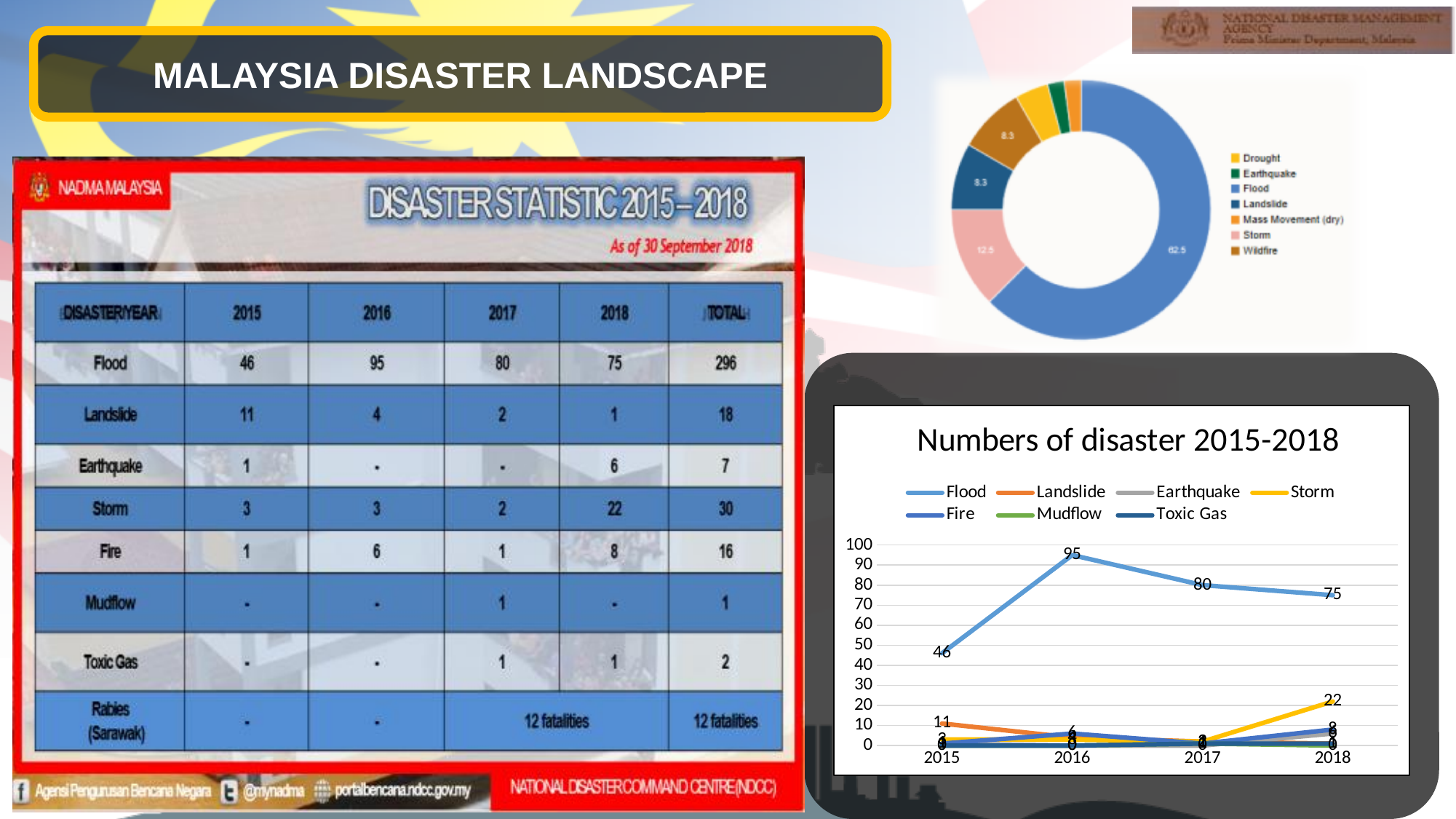
In the 'Numbers of disaster 2015-2018' chart, does the Flood line rise or fall from 2016 to 2018? Fall In the 'Numbers of disaster 2015-2018' chart, what is the Storm value for 2018? 22 In the 'Numbers of disaster 2015-2018' chart, what is the Flood value for 2016? 95 In the 'Numbers of disaster 2015-2018' chart, in which year is the Flood value lowest? 2015 In the 'Numbers of disaster 2015-2018' chart, what kind of chart is it? Line chart In the 'Numbers of disaster 2015-2018' chart, which year has the larger Flood value, 2017 or 2018? 2017 In the 'Numbers of disaster 2015-2018' chart, in which year is the Flood value highest? 2016 In the 'Numbers of disaster 2015-2018' chart, what is the difference between the Flood values for 2016 and 2017? 15 In the doughnut chart at the top right, which category has the largest slice? Flood In the 'Numbers of disaster 2015-2018' chart, how many series does the legend list? 7 In the 'Numbers of disaster 2015-2018' chart, how many years are shown on the x axis? 4 In the 'Numbers of disaster 2015-2018' chart, what is the Landslide value for 2015? 11